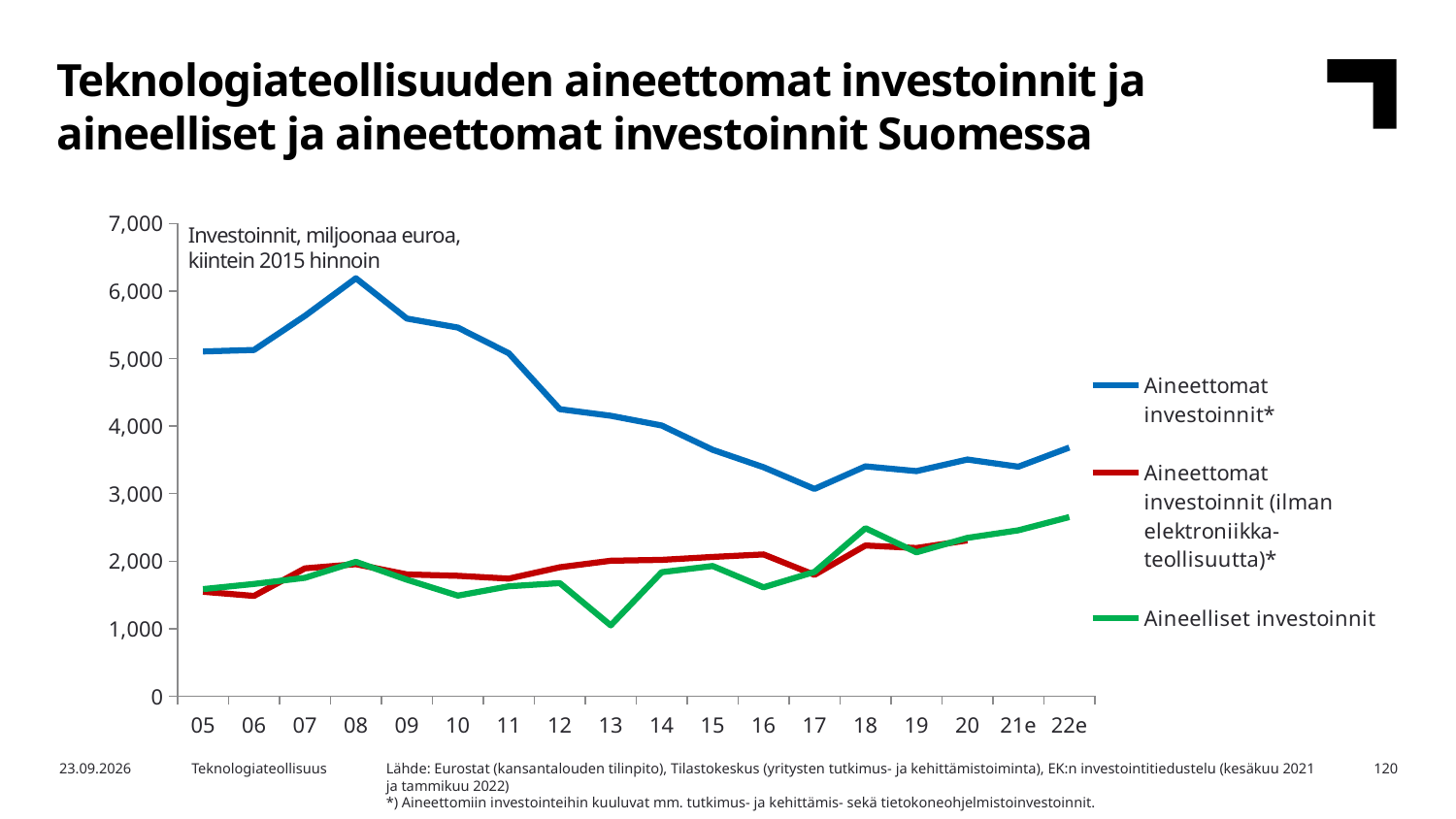
Is the value for Aineettomat investoinnit* in 08 greater or less than 6,000? greater Is the value for Aineelliset investoinnit in 18 greater or less than 2,000? greater How many series does the legend list? 3 Does the Aineettomat investoinnit* series rise or fall from 08 to 17? fall Does the Aineelliset investoinnit series rise or fall from 17 to 22e? rise In which year does the Aineettomat investoinnit* series reach its highest value? 08 What unit is stated in the text box inside the chart? Investoinnit, miljoonaa euroa, kiintein 2015 hinnoin In which year does the Aineelliset investoinnit series reach its lowest value? 13 In 13, which is larger: Aineettomat investoinnit (ilman elektroniikkateollisuutta)* or Aineelliset investoinnit? Aineettomat investoinnit (ilman elektroniikkateollisuutta)* How many points are on the x axis of the chart? 18 Is the value for Aineettomat investoinnit* in 12 greater or less than 4,000? greater What kind of chart is shown on the slide? line chart